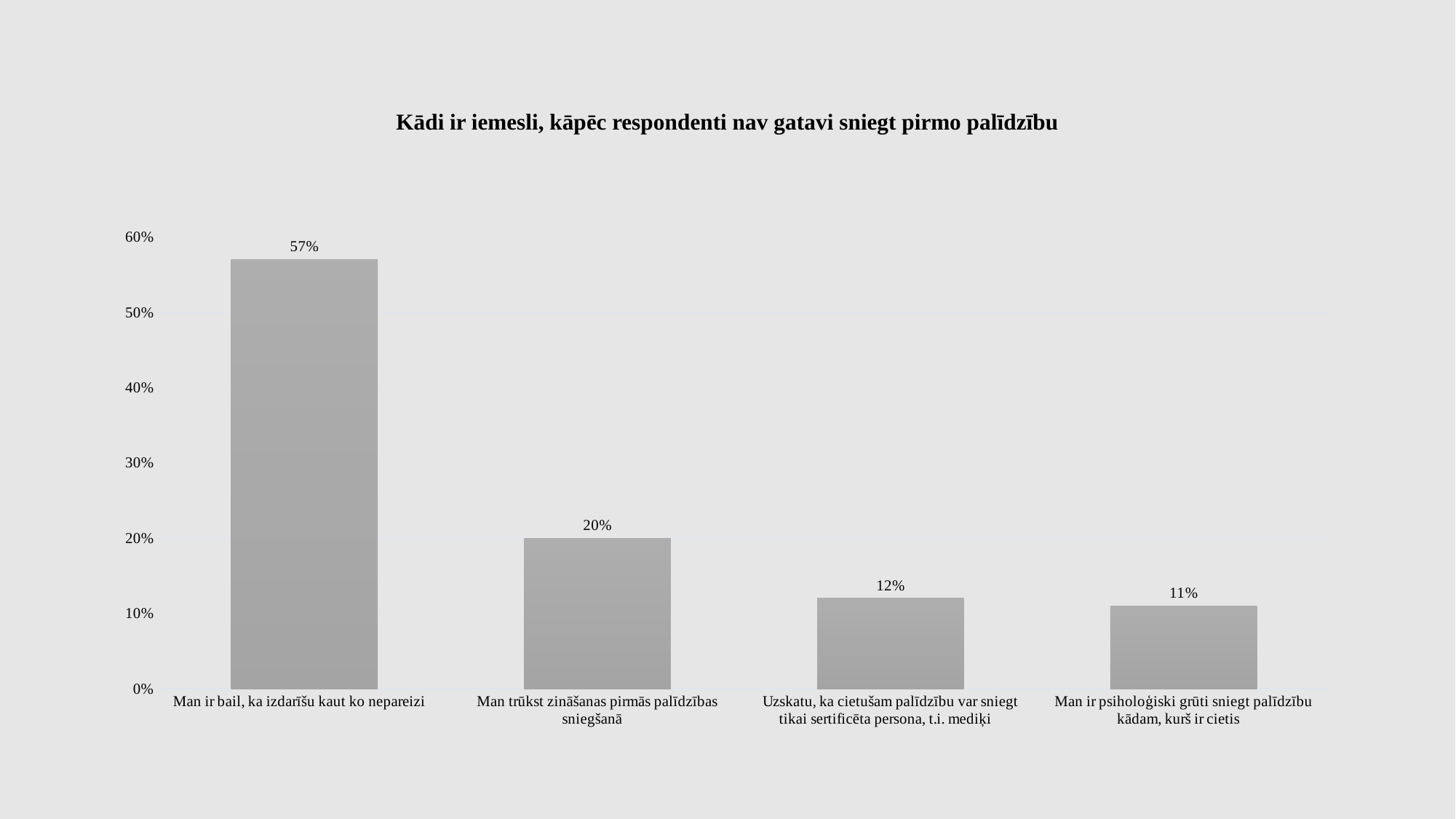
Which category has the lowest value? Man ir psiholoģiski grūti sniegt palīdzību kādam, kurš ir cietis What is the value for "Uzskatu, ka cietušam palīdzību var sniegt tikai sertificēta persona, t.i. mediķi"? 12% What is the value for "Man trūkst zināšanas pirmās palīdzības sniegšanā"? 20% What kind of chart is shown on the slide? bar chart How many categories are shown in the chart? 4 Which category has the highest value? Man ir bail, ka izdarīšu kaut ko nepareizi Which is larger: the value for "Man trūkst zināšanas pirmās palīdzības sniegšanā" or for "Uzskatu, ka cietušam palīdzību var sniegt tikai sertificēta persona, t.i. mediķi"? Man trūkst zināšanas pirmās palīdzības sniegšanā What is the difference between the values for "Man ir bail, ka izdarīšu kaut ko nepareizi" and "Man trūkst zināšanas pirmās palīdzības sniegšanā"? 37% Is the value for "Man ir bail, ka izdarīšu kaut ko nepareizi" greater or less than 50%? greater What is the title of the chart? Kādi ir iemesli, kāpēc respondenti nav gatavi sniegt pirmo palīdzību What is the value for "Man ir psiholoģiski grūti sniegt palīdzību kādam, kurš ir cietis"? 11% What is the value for "Man ir bail, ka izdarīšu kaut ko nepareizi"? 57%